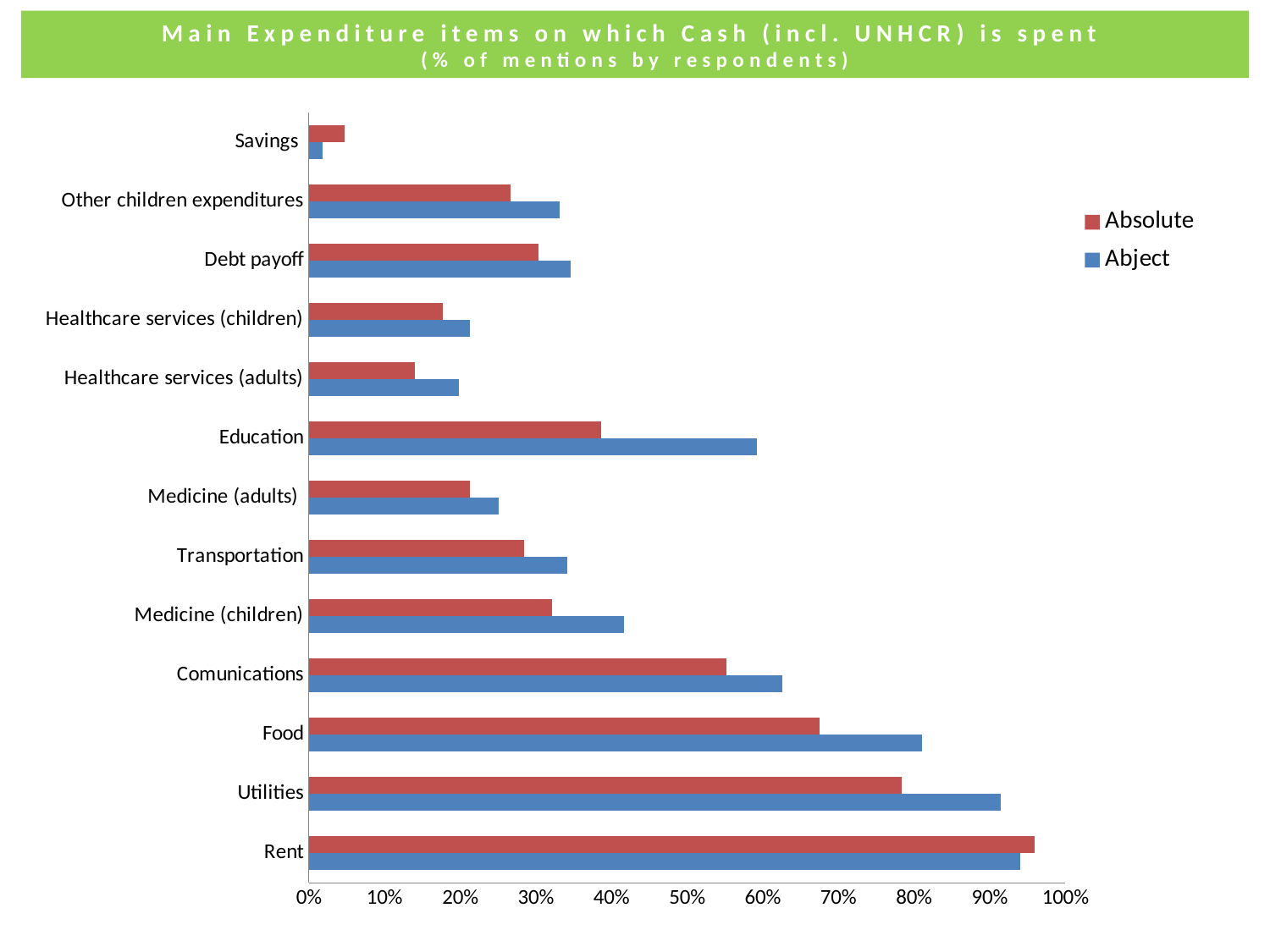
How many series does the legend list? 2 Is the Abject value for Utilities greater or less than 80%? greater Which category has the lowest value for the Absolute series? Savings How many expenditure categories are plotted on the chart? 13 Is the Abject value for Education greater or less than 50%? greater For Education, which series has the larger value, Absolute or Abject? Abject Which category has the highest value for the Abject series? Rent Is the Absolute value for Rent greater or less than 90%? greater What colour are the bars for the Abject series? blue What kind of chart is shown on the slide? bar chart For Savings, which series has the larger value, Absolute or Abject? Absolute